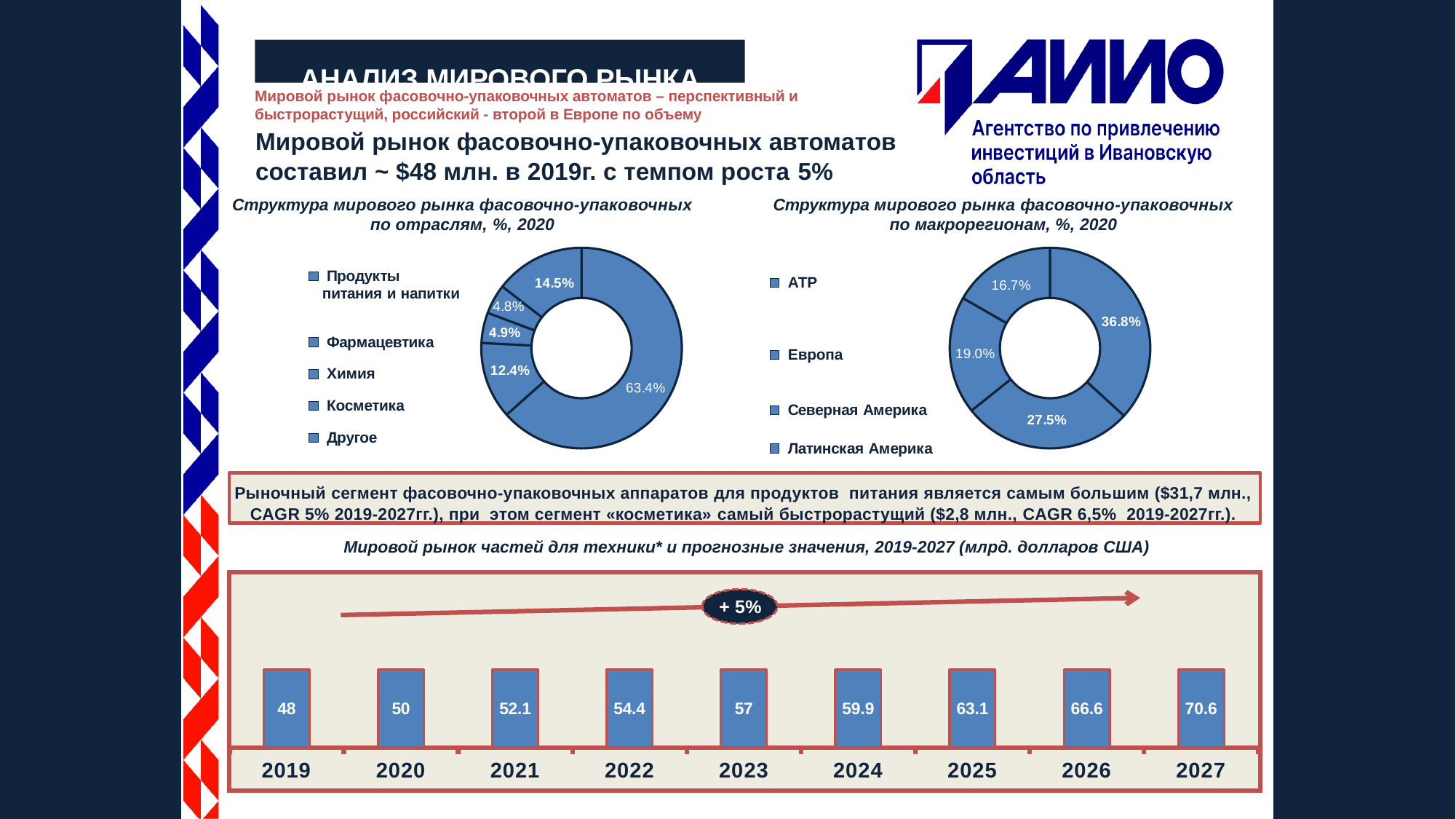
In the right donut chart 'Структура мирового рынка фасовочно-упаковочных по макрорегионам, %, 2020', what is the largest share shown? 36.8% In the bottom chart 'Мировой рынок частей для техники* и прогнозные значения, 2019-2027', what is the value for 2027? 70.6 In the bottom chart 'Мировой рынок частей для техники* и прогнозные значения, 2019-2027', do the values rise or fall from 2019 to 2027? rise In the bottom chart 'Мировой рынок частей для техники* и прогнозные значения, 2019-2027', what is the value for 2024? 59.9 In the bottom chart 'Мировой рынок частей для техники* и прогнозные значения, 2019-2027', which year has the highest value? 2027 In the bottom chart 'Мировой рынок частей для техники* и прогнозные значения, 2019-2027', which year has the lowest value? 2019 In the left donut chart 'Структура мирового рынка фасовочно-упаковочных по отраслям, %, 2020', what is the share of the largest slice (Продукты питания и напитки)? 63.4% In the bottom chart 'Мировой рынок частей для техники* и прогнозные значения, 2019-2027', what is the value for 2019? 48 What kind of chart is the bottom chart 'Мировой рынок частей для техники* и прогнозные значения, 2019-2027'? bar chart In the bottom chart 'Мировой рынок частей для техники* и прогнозные значения, 2019-2027', what is the difference between the values for 2027 and 2019? 22.6 How many categories does the legend of the right donut chart 'Структура мирового рынка фасовочно-упаковочных по макрорегионам, %, 2020' list? 4 In the bottom chart 'Мировой рынок частей для техники* и прогнозные значения, 2019-2027', how many years are shown? 9